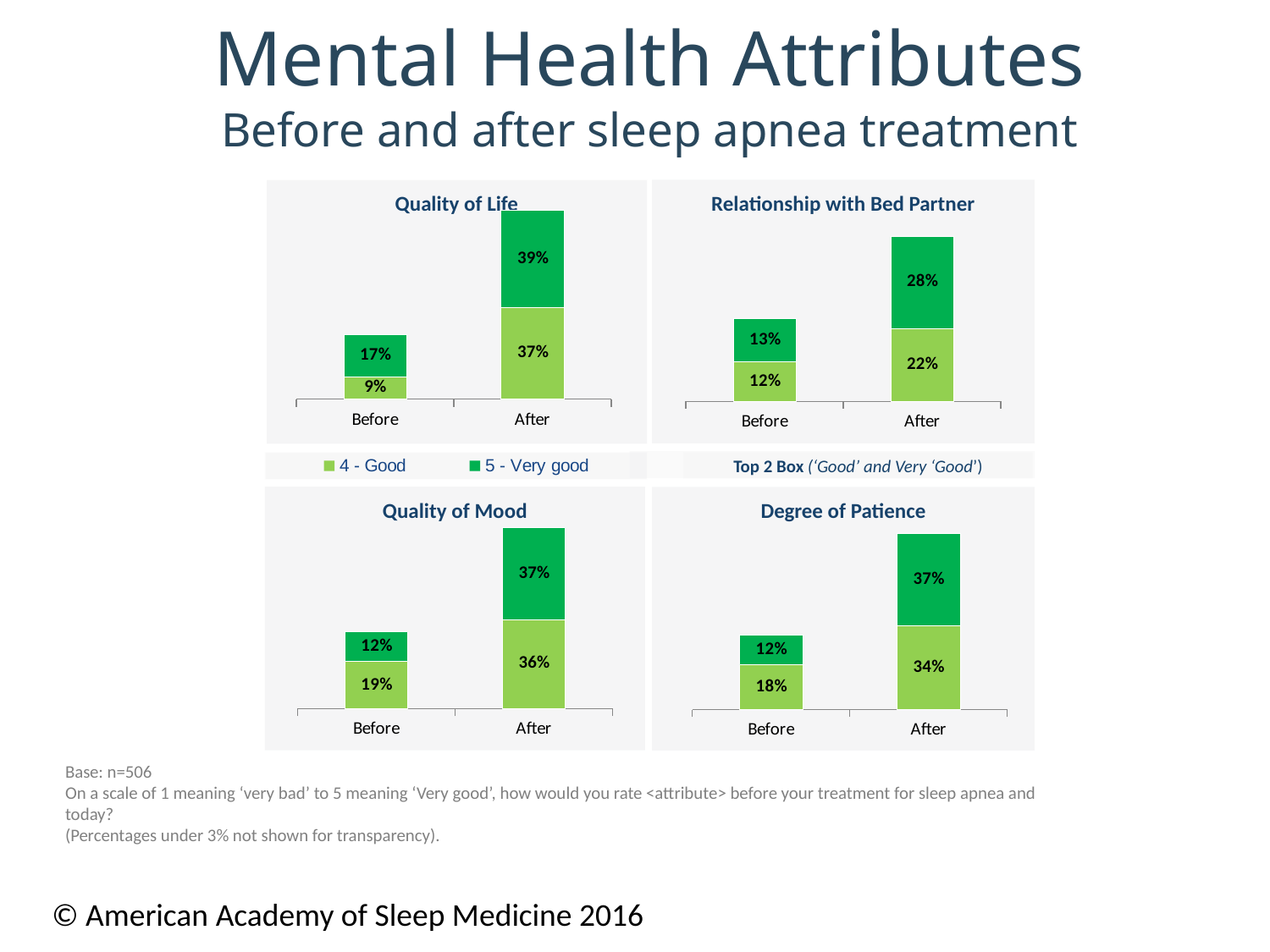
In the Relationship with Bed Partner chart, what is the '4 - Good' value for After? 22% In the Relationship with Bed Partner chart, which bar is taller, Before or After? After In the Quality of Mood chart, what is the difference between the '4 - Good' values for After and Before? 17% In the Degree of Patience chart, what is the '4 - Good' value for After? 34% In the Degree of Patience chart, what is the total (Top 2 Box) for the After bar? 71% In the Quality of Life chart, what is the '4 - Good' value for Before? 9% What type of chart is the Quality of Mood chart? Stacked bar chart In the Relationship with Bed Partner chart, what is the total (Top 2 Box) for the Before bar? 25% In the Quality of Mood chart, what is the '5 - Very good' value for Before? 12% In the Quality of Life chart, what is the '5 - Very good' value for After? 39% In the Quality of Life chart, what is the total (Top 2 Box) for the After bar? 76% How many series does the legend list for these charts? 2